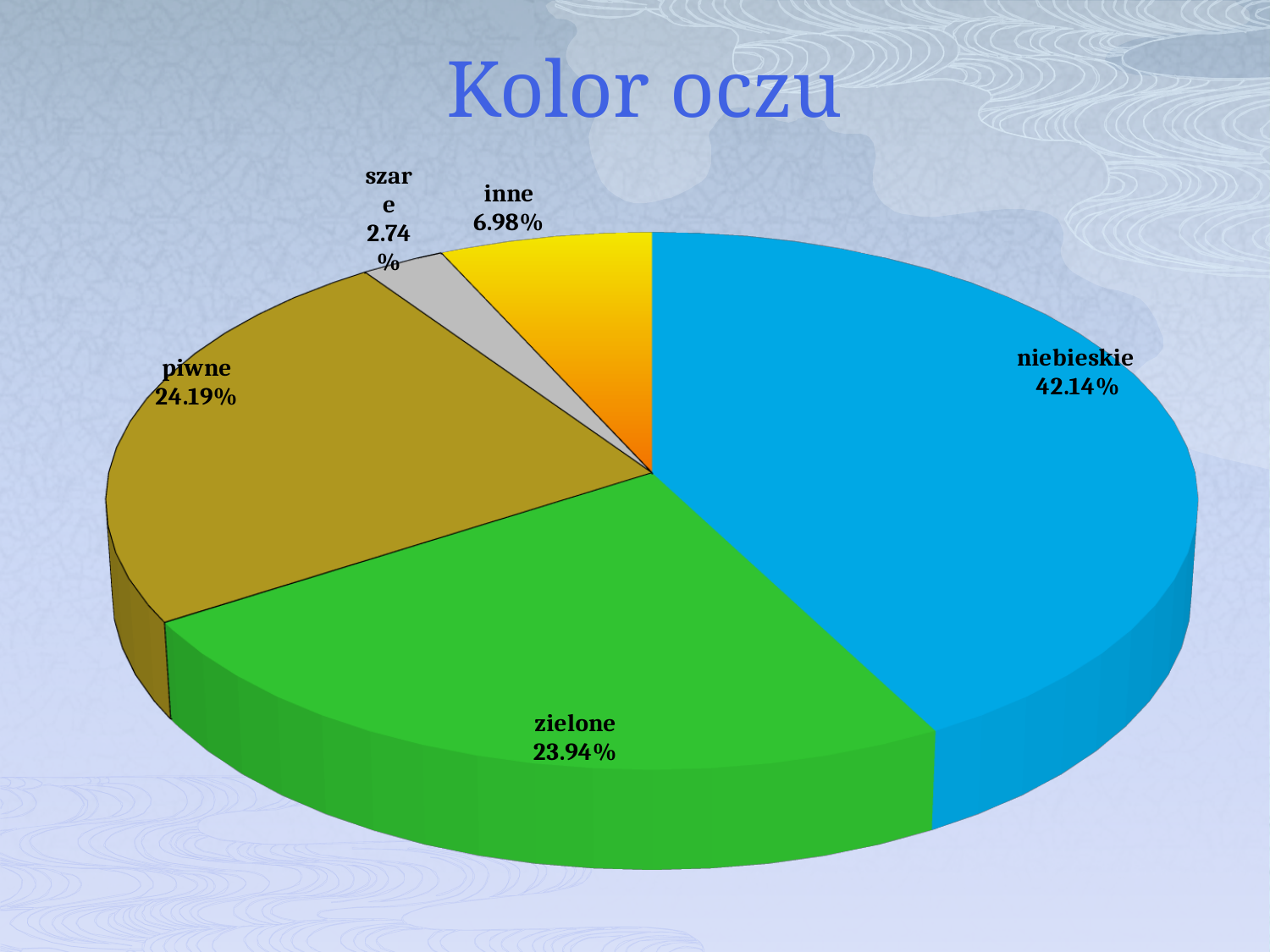
How many slices does the pie chart have? 5 What is the title of the chart? Kolor oczu What percentage is shown for the szare slice? 2.74% What percentage is shown for the piwne slice? 24.19% What percentage is shown for the inne slice? 6.98% What share of the pie does the niebieskie slice represent? 42.14% What percentage is shown for the zielone slice? 23.94% By how many percentage points does the niebieskie slice exceed the zielone slice? 18.20 percentage points Which eye colour has the largest slice of the pie? niebieskie What kind of chart is shown on the slide? pie chart Which slice is larger, inne or szare? inne Which eye colour has the smallest slice of the pie? szare